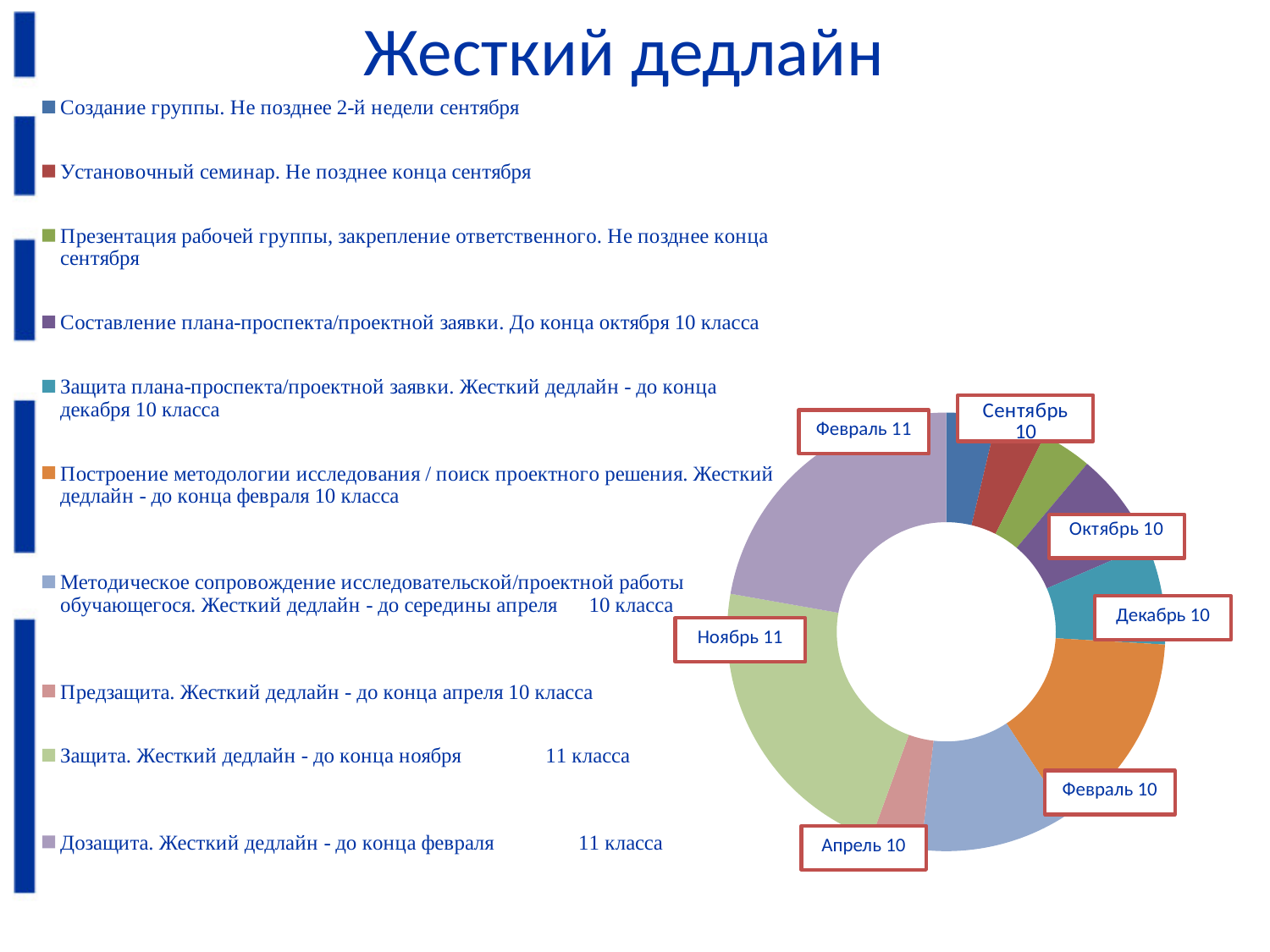
How many entries does the chart's legend list? 10 How many slices does the doughnut chart have? 10 What kind of chart is shown on the slide? doughnut chart Which callout label is attached to the orange slice of the chart? Февраль 10 Which slice is larger: the one labelled 'Ноябрь 11' or the one labelled 'Февраль 10'? Ноябрь 11 Which slice is larger: the one labelled 'Февраль 11' or the one labelled 'Сентябрь 10'? Февраль 11 Which slice is larger: the one labelled 'Февраль 10' or the one labelled 'Апрель 10'? Февраль 10 What is the title of the slide containing the chart? Жесткий дедлайн What colour is the slice for 'Защита. Жесткий дедлайн - до конца ноября 11 класса'? light green